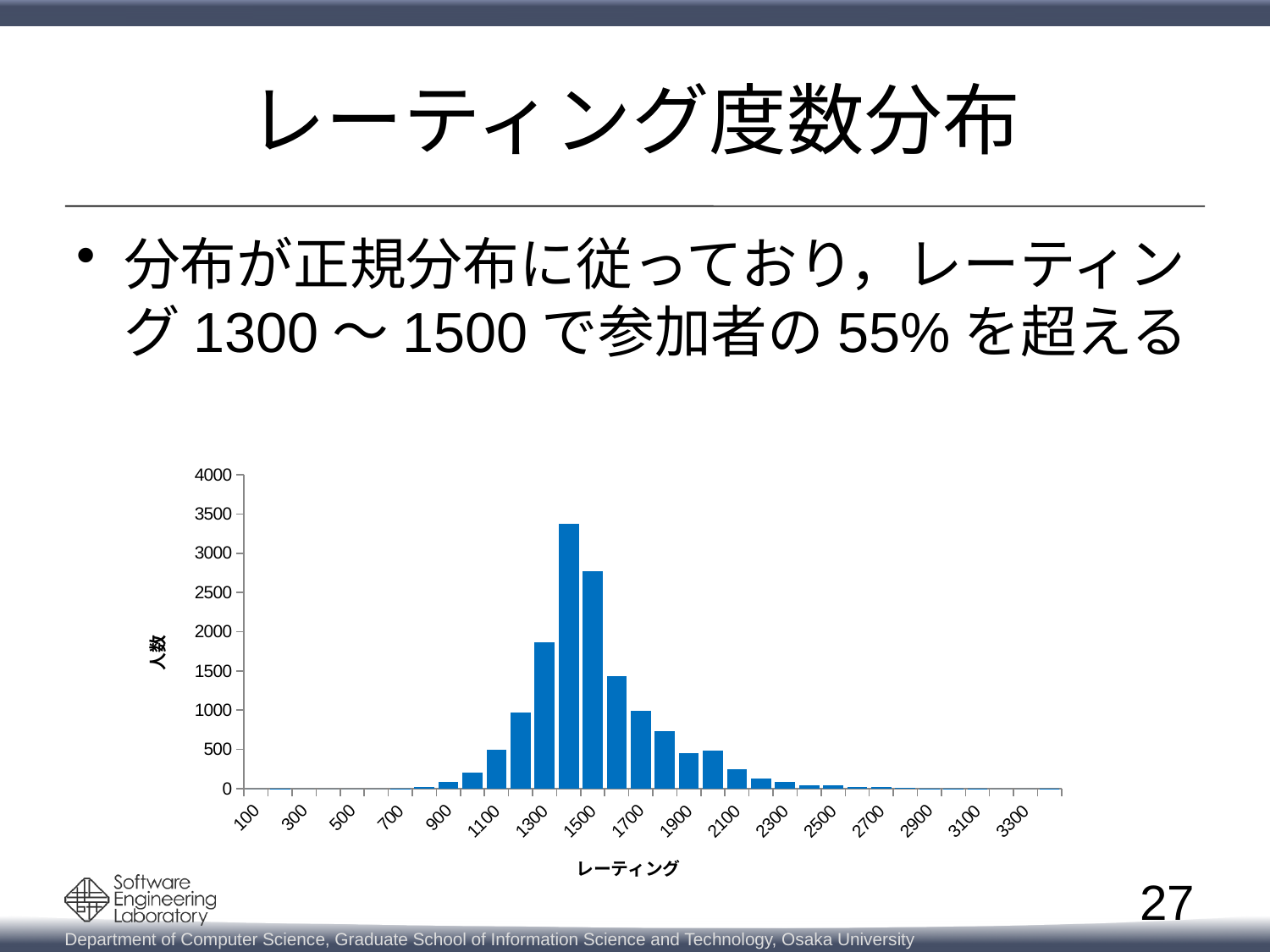
Is the value for rating 1500 greater or less than 1000? greater What is the title of the chart's vertical axis? 人数 Is the value of the tallest bar greater or less than 3500? less Do the bar values rise or fall as the rating increases from 1500 to 2100? fall Which is larger, the value for rating 1500 or the value for rating 2300? 1500 What is the title of the chart's horizontal axis? レーティング Is the value of the tallest bar greater or less than 3000? greater What kind of chart is shown on the slide? bar chart